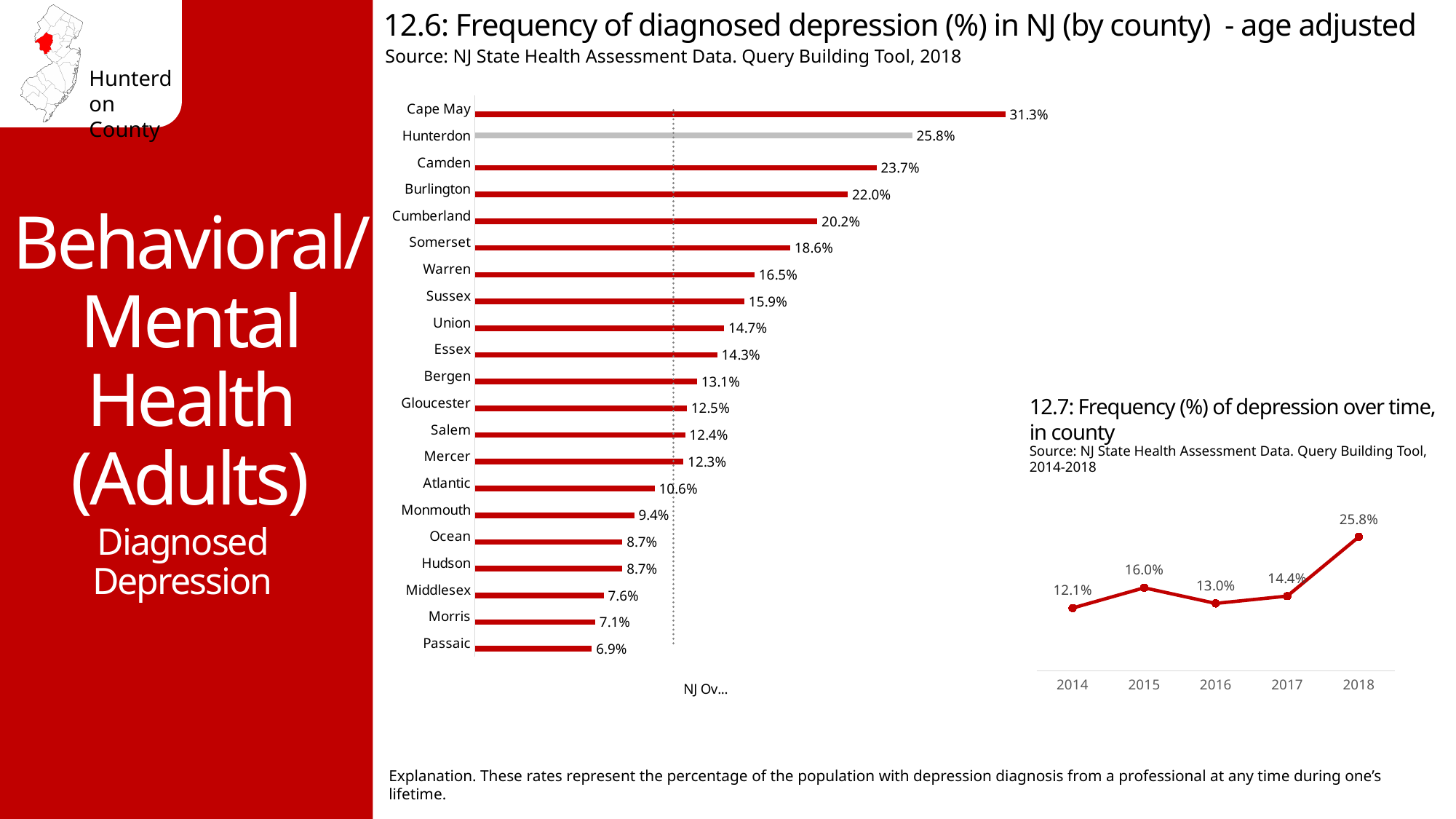
What kind of chart is chart 12.7 (frequency of depression over time)? Line chart What kind of chart is chart 12.6 (frequency of diagnosed depression by county)? Bar chart In chart 12.6 (frequency of diagnosed depression by county), what is the value for Morris? 7.1% In chart 12.6 (frequency of diagnosed depression by county), which is larger, Somerset or Warren? Somerset In chart 12.6 (frequency of diagnosed depression by county), which county has the highest value? Cape May In chart 12.6 (frequency of diagnosed depression by county), what is the value for Hunterdon? 25.8% In chart 12.7 (frequency of depression over time), what is the difference between 2018 and 2017? 11.4% In chart 12.7 (frequency of depression over time), what is the value for 2016? 13.0% In chart 12.6 (frequency of diagnosed depression by county), how many counties are shown? 21 In chart 12.7 (frequency of depression over time), which year has the highest value? 2018 In chart 12.6 (frequency of diagnosed depression by county), which county has the lowest value? Passaic In chart 12.6 (frequency of diagnosed depression by county), what is the difference between Cape May and Hunterdon? 5.5%